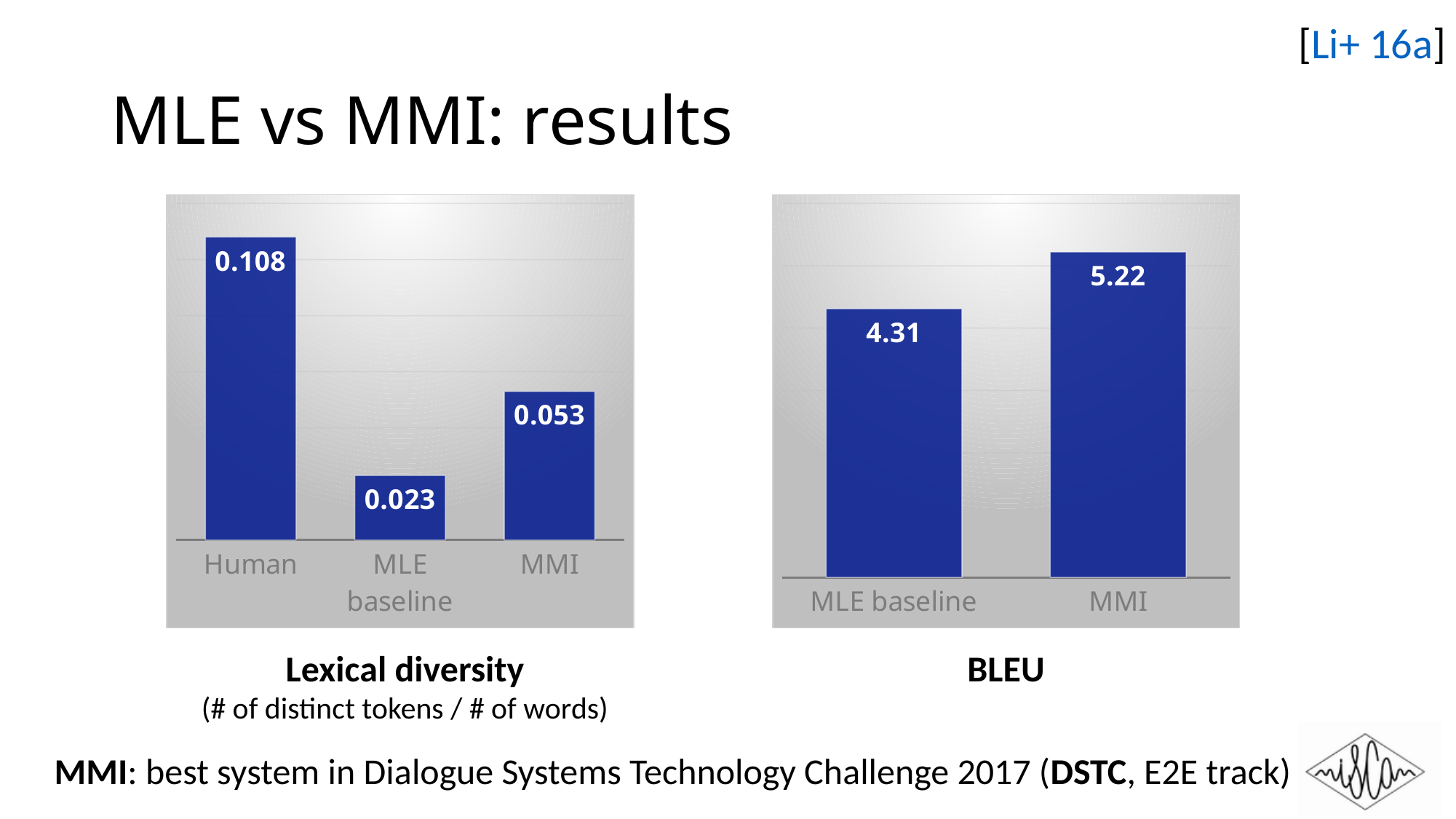
In the Lexical diversity chart, which category has the lowest value? MLE baseline In the Lexical diversity chart, which category has the highest value? Human In the Lexical diversity chart, what is the value for MLE baseline? 0.023 In the BLEU chart, which is larger, MLE baseline or MMI? MMI In the Lexical diversity chart, what is the difference between MMI and MLE baseline? 0.030 In the Lexical diversity chart, what is the value for Human? 0.108 What kind of chart is the BLEU chart? Bar chart How many categories are shown in the Lexical diversity chart? 3 In the BLEU chart, what is the value for MMI? 5.22 In the Lexical diversity chart, what is the value for MMI? 0.053 In the BLEU chart, what is the value for MLE baseline? 4.31 In the BLEU chart, what is the difference between MMI and MLE baseline? 0.91